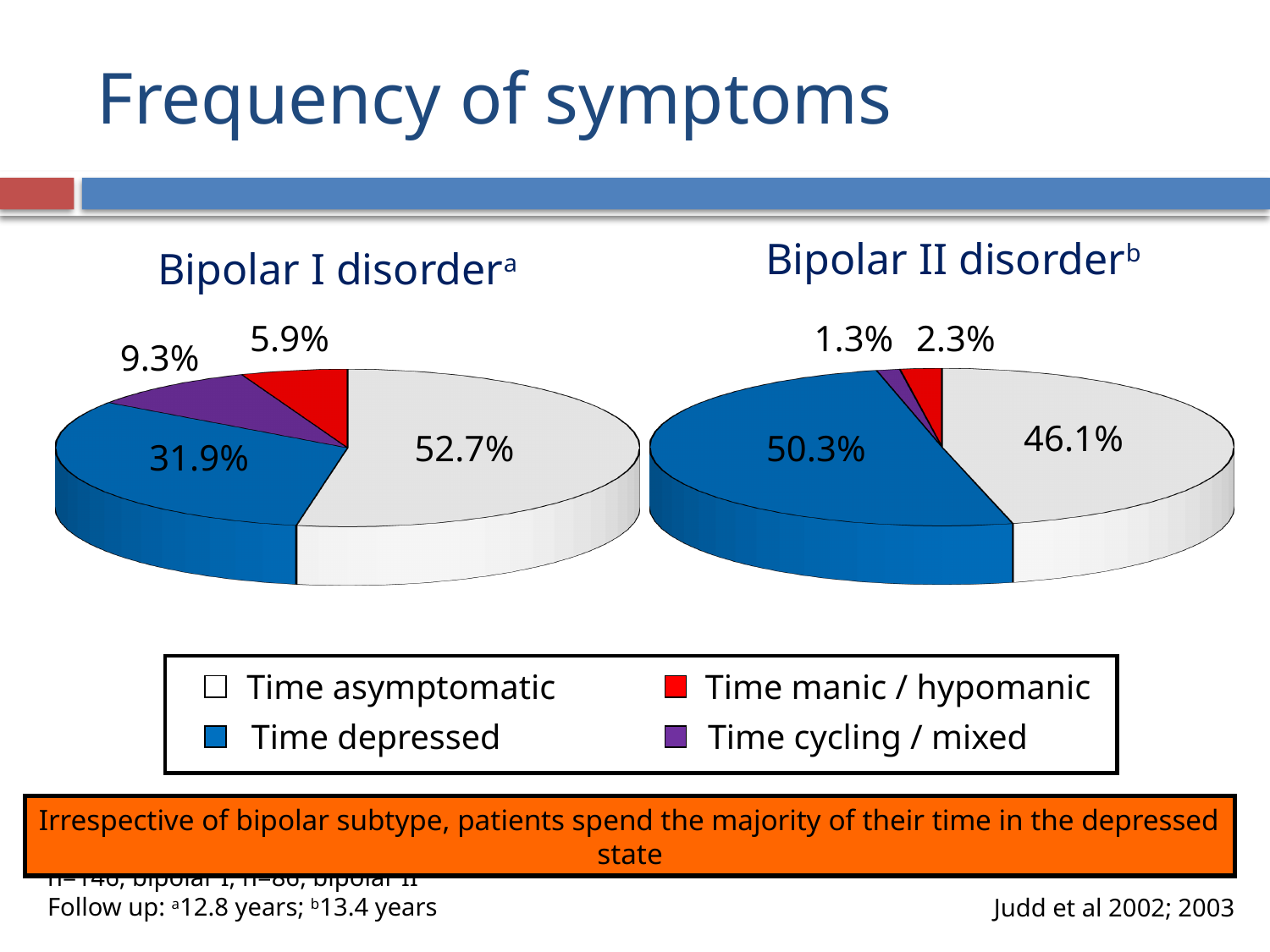
In the Bipolar II disorder chart, what percentage of time is manic / hypomanic? 2.3% How many slices does each pie chart have? 4 In the Bipolar I disorder chart, what percentage of time is cycling / mixed? 9.3% In the Bipolar I disorder chart, what percentage of time is depressed? 31.9% Which colour represents time cycling / mixed in the legend? Purple In the Bipolar I disorder chart, what percentage of time is asymptomatic? 52.7% In the Bipolar II disorder chart, what percentage of time is depressed? 50.3% In the Bipolar I disorder chart, what is the difference between time asymptomatic and time depressed? 20.8% In the Bipolar II disorder chart, which category has the largest share? Time depressed In the Bipolar I disorder chart, which category has the smallest share? Time manic / hypomanic What kind of charts are shown on the slide? Pie charts Which chart shows a larger share of time depressed, Bipolar I disorder or Bipolar II disorder? Bipolar II disorder